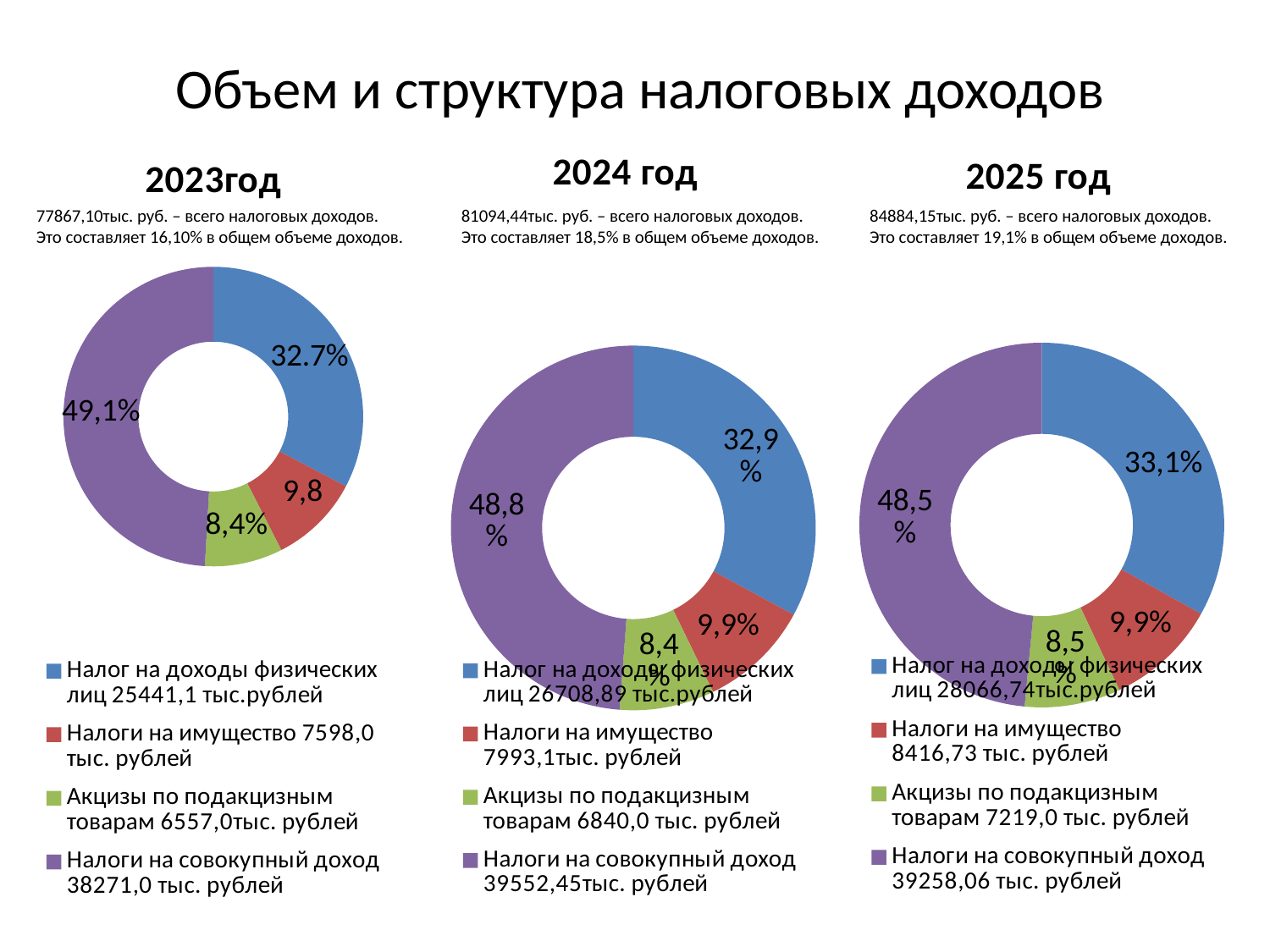
How many categories does each doughnut chart contain? 4 How many charts are shown on the slide? 3 In the 2025 chart, which category has the largest slice? Налоги на совокупный доход In the 2024 chart, what share is shown for Налог на доходы физических лиц? 32,9% What kind of chart is used on this slide for each year? doughnut (pie) chart In the 2024 chart, which slice is larger: Налоги на имущество or Акцизы по подакцизным товарам? Налоги на имущество In the 2023 chart, what share is shown for Налоги на совокупный доход? 49,1% In the 2023 chart, which category has the smallest slice? Акцизы по подакцизным товарам In the 2025 chart, what is the difference in percentage points between the Налоги на совокупный доход slice and the Налог на доходы физических лиц slice? 15,4 According to the 2024 chart legend, what is the amount for Налоги на совокупный доход? 39552,45 тыс. рублей In the 2025 chart, what share is shown for Акцизы по подакцизным товарам? 8,5% Does the share of Налог на доходы физических лиц rise or fall from the 2023 chart to the 2025 chart? rises